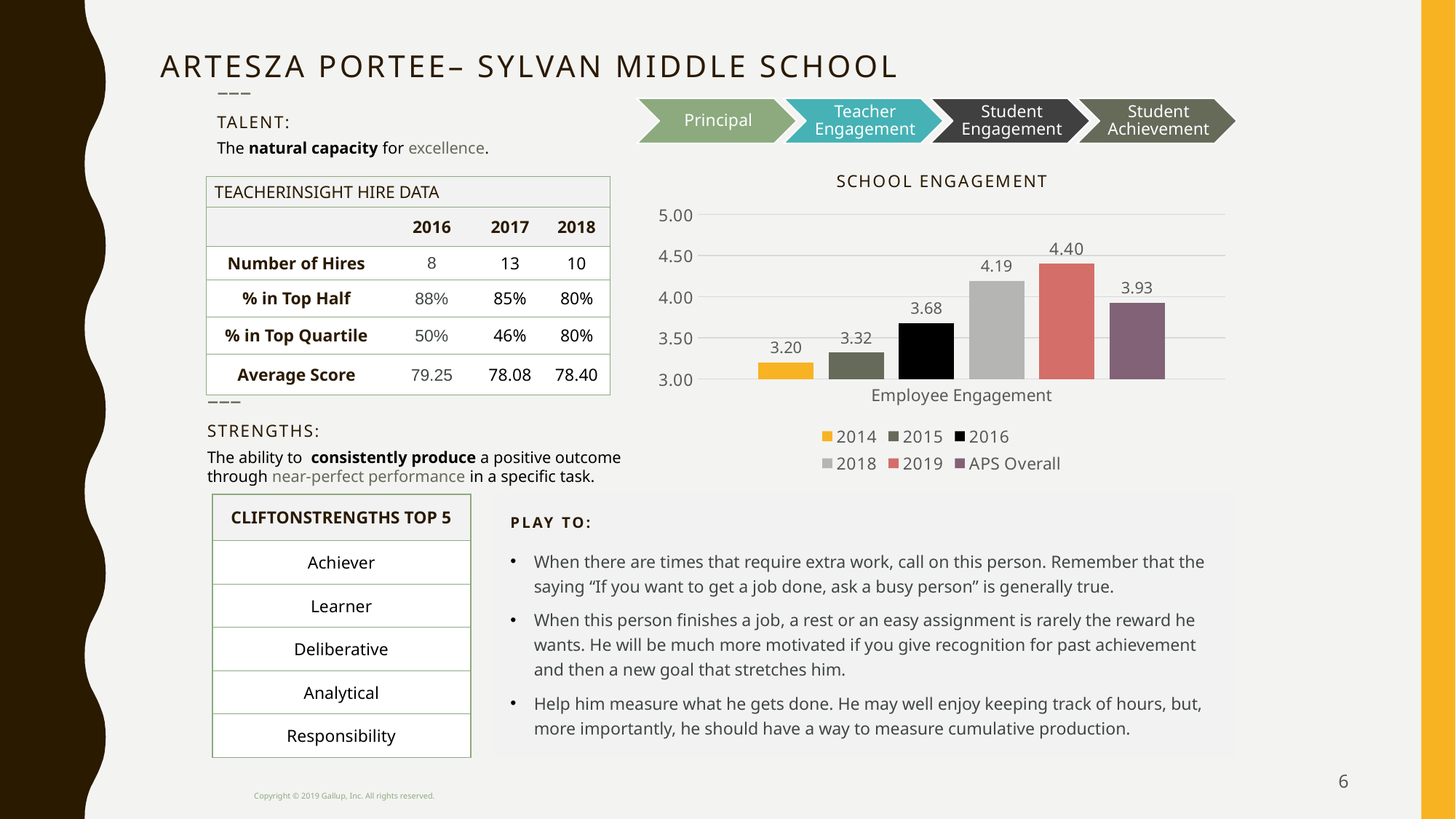
Is the 2015 value in the School Engagement chart greater or less than 3.50? less What is the x-axis category label in the School Engagement chart? Employee Engagement Which series has the lowest value in the School Engagement chart? 2014 Which is larger in the School Engagement chart, the 2016 value or the APS Overall value? APS Overall What is the Employee Engagement value for 2019 in the School Engagement chart? 4.40 What kind of chart is the School Engagement chart? bar chart Do the values in the School Engagement chart rise or fall from 2014 to 2019? rise Which series has the highest value in the School Engagement chart? 2019 What is the APS Overall value in the School Engagement chart? 3.93 What is the difference between the 2019 and 2018 values in the School Engagement chart? 0.21 What is the Employee Engagement value for 2014 in the School Engagement chart? 3.20 How many series does the legend of the School Engagement chart list? 6